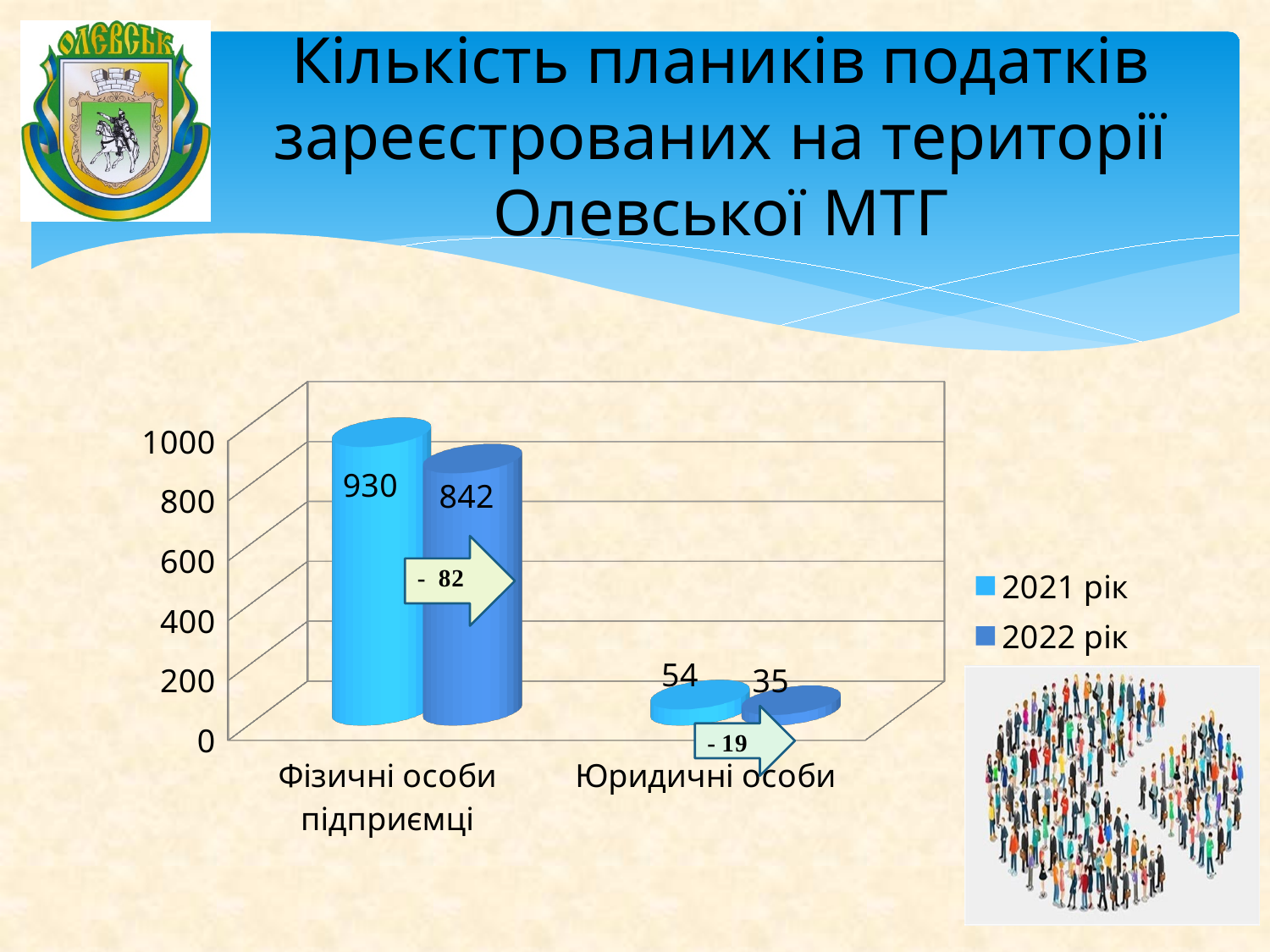
Which is larger for Юридичні особи: the 2021 рік value or the 2022 рік value? 2021 рік Which category has the highest value in 2021 рік? Фізичні особи підприємці Which category has the lowest value in 2022 рік? Юридичні особи What is the value for Юридичні особи in 2021 рік? 54 What is the difference between the 2021 рік and 2022 рік values for Фізичні особи підприємці? 88 What is the value for Юридичні особи in 2022 рік? 35 How many categories are shown on the x axis? 2 What kind of chart is shown on the slide? Bar chart What is the difference between the 2021 рік and 2022 рік values for Юридичні особи? 19 What is the value for Фізичні особи підприємці in 2021 рік? 930 How many series does the legend list? 2 What is the value for Фізичні особи підприємці in 2022 рік? 842